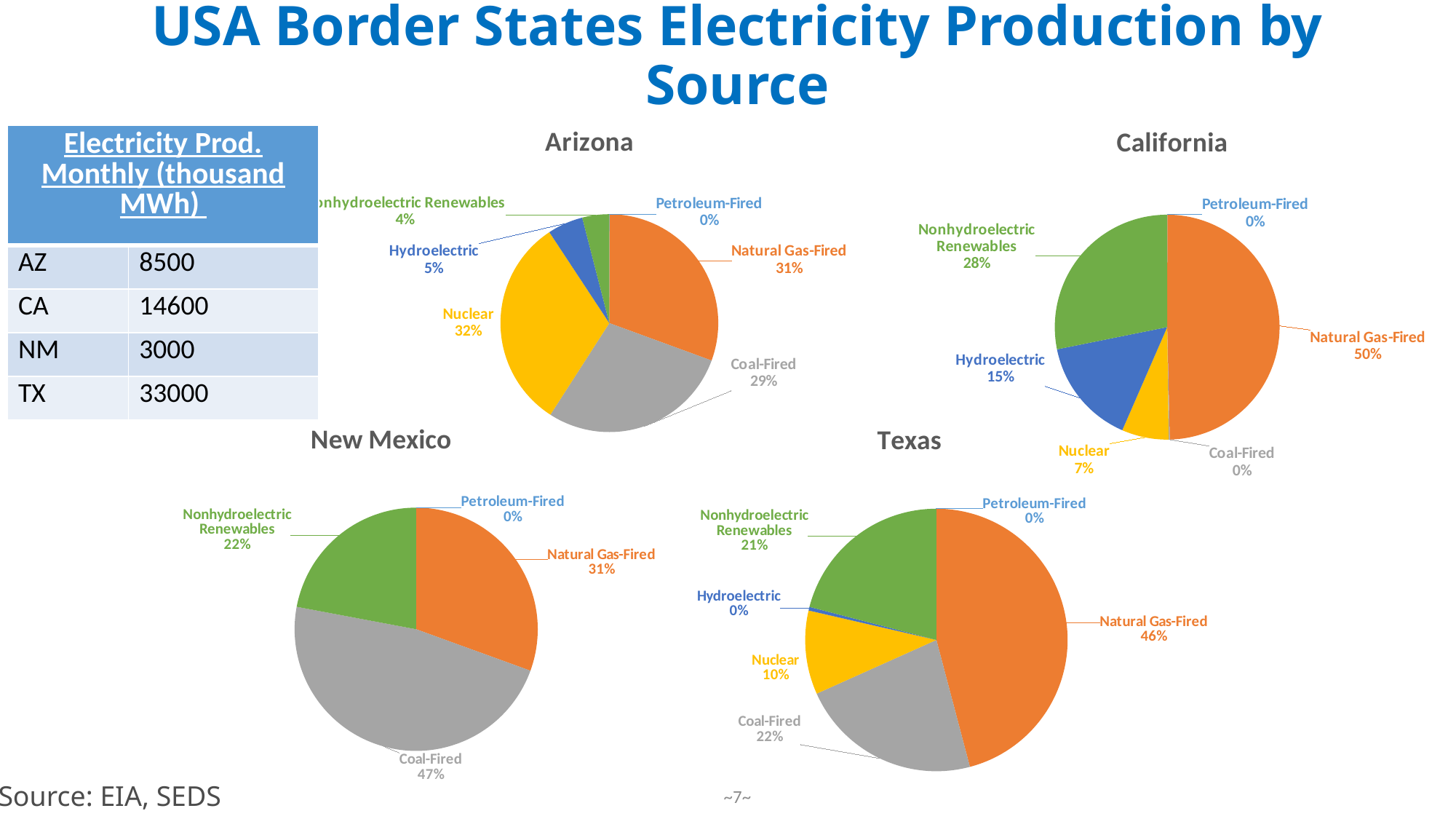
In the California chart, what share of electricity production comes from Natural Gas-Fired? 50% In the Arizona chart, which source has the largest share? Nuclear In the California chart, what is the difference between the Nonhydroelectric Renewables share and the Hydroelectric share? 13% In the Texas chart, what share of electricity production comes from Nonhydroelectric Renewables? 21% What kind of chart is used for each state on the slide? Pie chart In the California chart, what share of electricity production comes from Coal-Fired? 0% How many pie charts are shown on the slide? 4 In the Texas chart, what is the difference between the Natural Gas-Fired share and the Coal-Fired share? 24% In the New Mexico chart, which source has the largest share? Coal-Fired In the Texas chart, which is larger, the Coal-Fired share or the Nuclear share? Coal-Fired